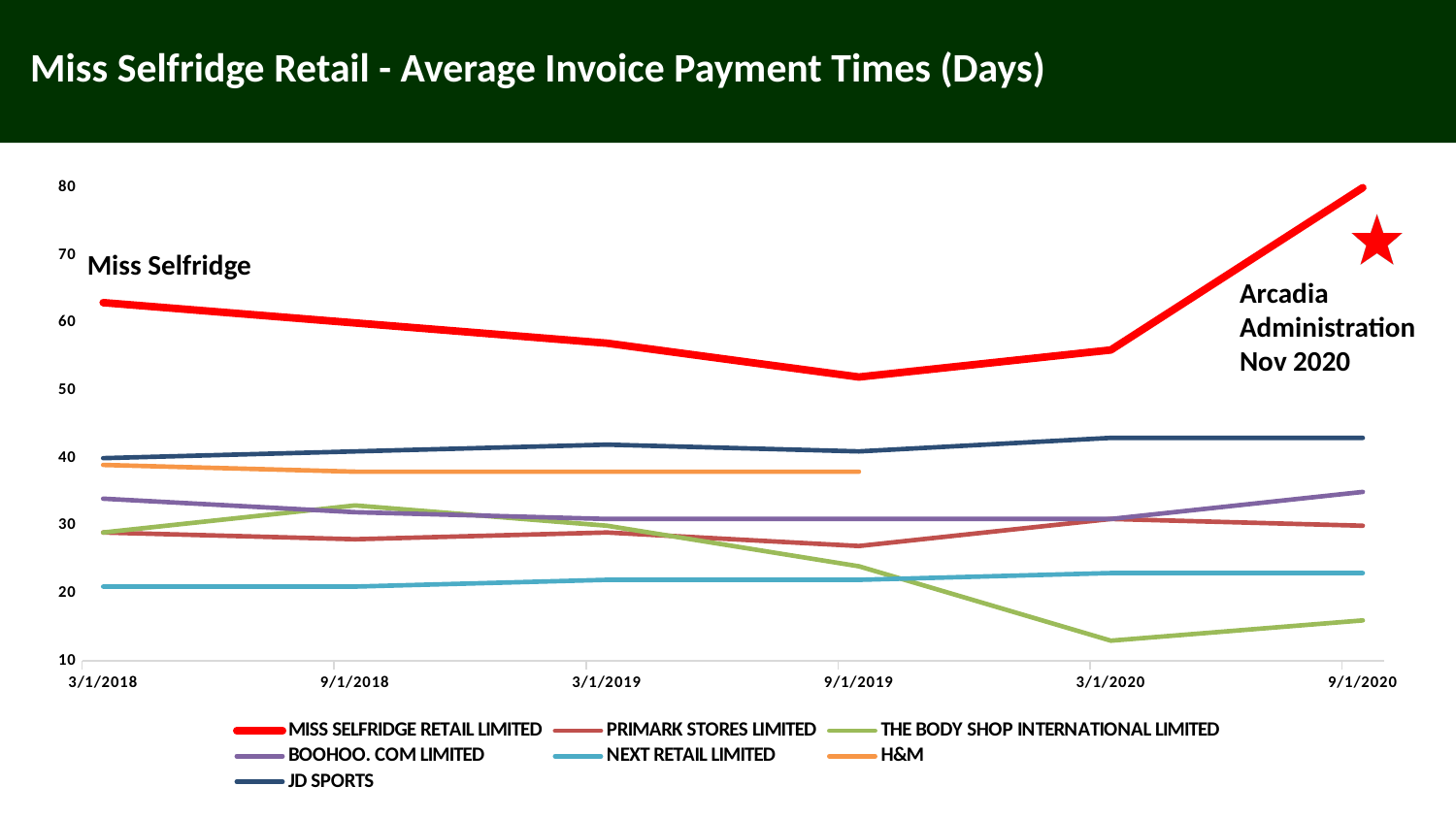
How many series does the legend list? 7 At 3/1/2018, which is larger: the value for JD SPORTS or the value for NEXT RETAIL LIMITED? JD SPORTS Is the value for JD SPORTS at 3/1/2020 greater or less than 40? greater Is the value for THE BODY SHOP INTERNATIONAL LIMITED at 3/1/2020 greater or less than 20? less Does the MISS SELFRIDGE RETAIL LIMITED line rise or fall between 9/1/2019 and 9/1/2020? Rise What kind of chart is shown on the slide? Line chart Does the THE BODY SHOP INTERNATIONAL LIMITED line rise or fall between 9/1/2018 and 3/1/2020? Fall How many dates are shown along the x axis? 6 Which series has the lowest value at 9/1/2020? THE BODY SHOP INTERNATIONAL LIMITED Is the value for MISS SELFRIDGE RETAIL LIMITED at 9/1/2020 greater or less than 70? greater What is the title of the chart? Miss Selfridge Retail - Average Invoice Payment Times (Days) Which series has the highest value at 9/1/2020? MISS SELFRIDGE RETAIL LIMITED